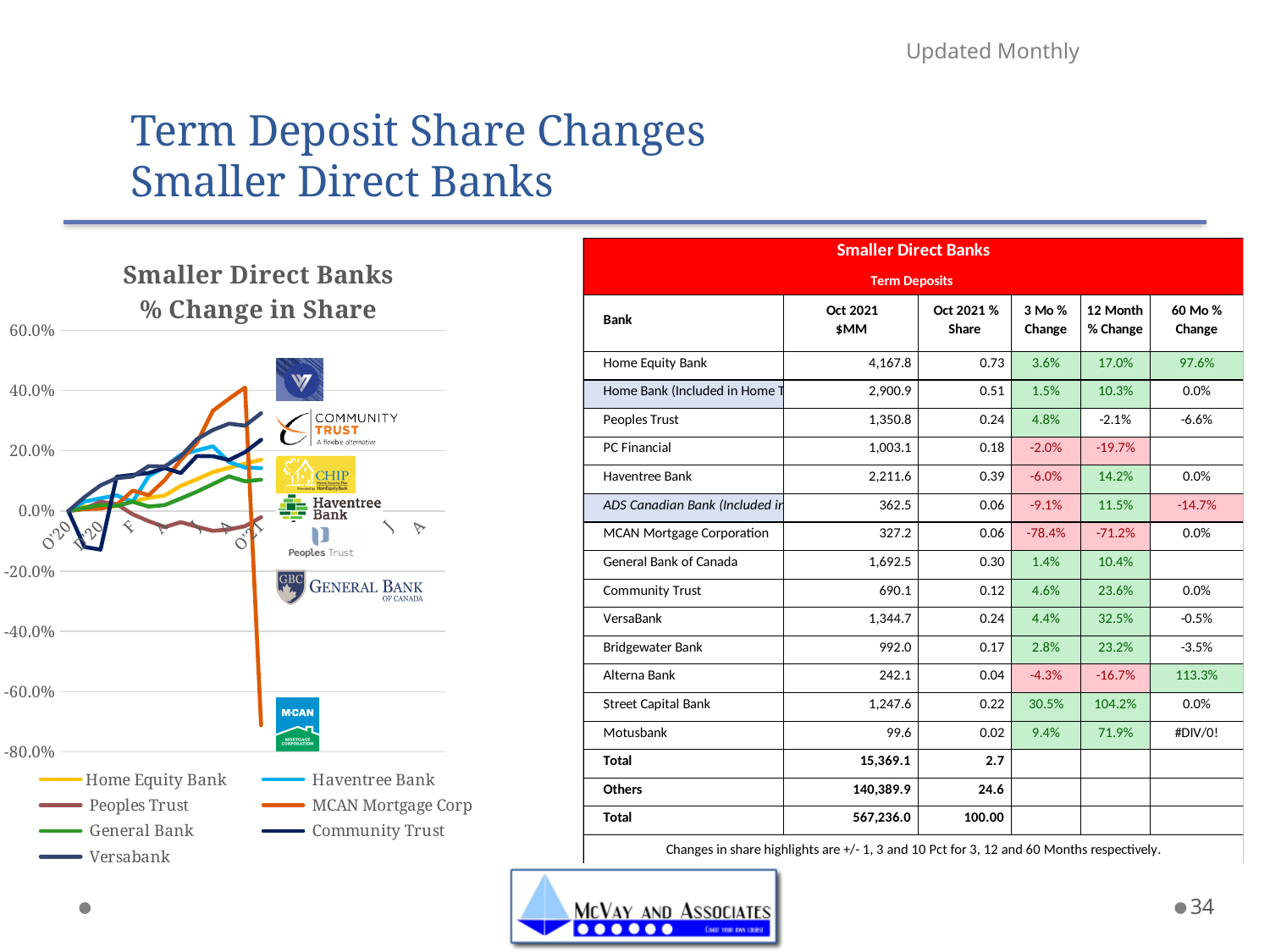
What is the highest value shown on the y axis of the "Smaller Direct Banks % Change in Share" chart? 60.0% In the "Smaller Direct Banks % Change in Share" chart, is the final value for Versabank greater or less than 20.0%? greater In the "Smaller Direct Banks % Change in Share" chart, is the final value for General Bank greater or less than 0.0%? greater In the "Smaller Direct Banks % Change in Share" chart, which series ends at the lowest value at the right end of the x axis? MCAN Mortgage Corp How many series does the legend of the "Smaller Direct Banks % Change in Share" chart list? 7 What is the title of the chart on the left of the slide? Smaller Direct Banks % Change in Share In the "Smaller Direct Banks % Change in Share" chart, which series reaches the highest point on the chart? MCAN Mortgage Corp In the "Smaller Direct Banks % Change in Share" chart, does the MCAN Mortgage Corp line rise or fall at the last point on the x axis? Fall In the "Smaller Direct Banks % Change in Share" chart, which series has the larger final value, Versabank or Haventree Bank? Versabank In the "Smaller Direct Banks % Change in Share" chart, is the final value for MCAN Mortgage Corp greater or less than -60.0%? less In the "Smaller Direct Banks % Change in Share" chart, does the Versabank line generally rise or fall from O'20 to O'21? Rise What kind of chart is shown on the left of the slide? Line chart